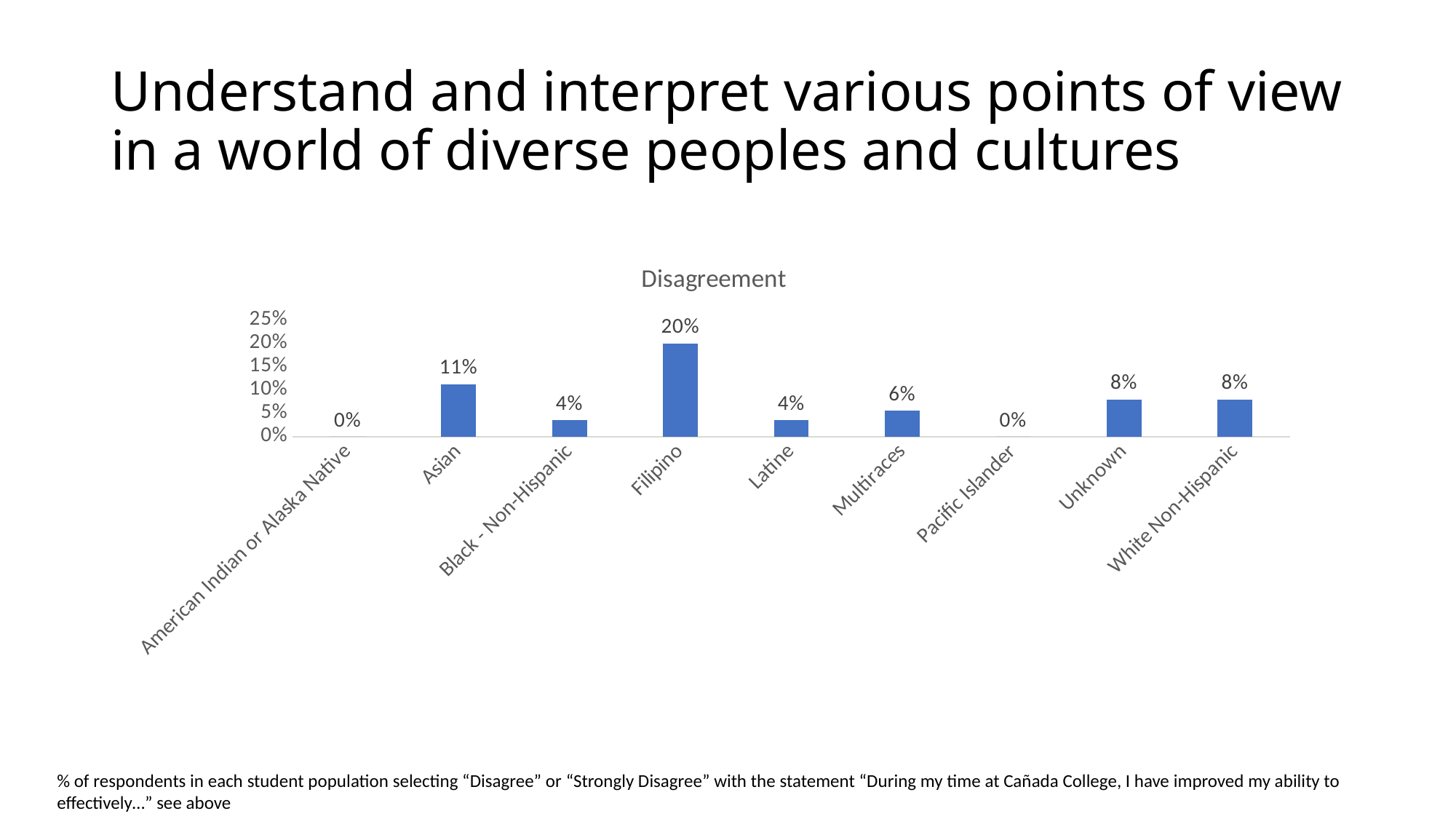
What is the difference between the values for Filipino and Asian? 9% What is the title of the chart? Disagreement What is the value for Filipino? 20% What is the difference between the values for Unknown and Latine? 4% What is the value for Multiraces? 6% What is the value for Pacific Islander? 0% How many categories are shown on the x axis? 9 Which is larger, the value for Asian or the value for Multiraces? Asian Is the value for Filipino greater or less than 15%? greater What is the value for Asian? 11% What kind of chart is shown? bar chart Which category has the highest value? Filipino